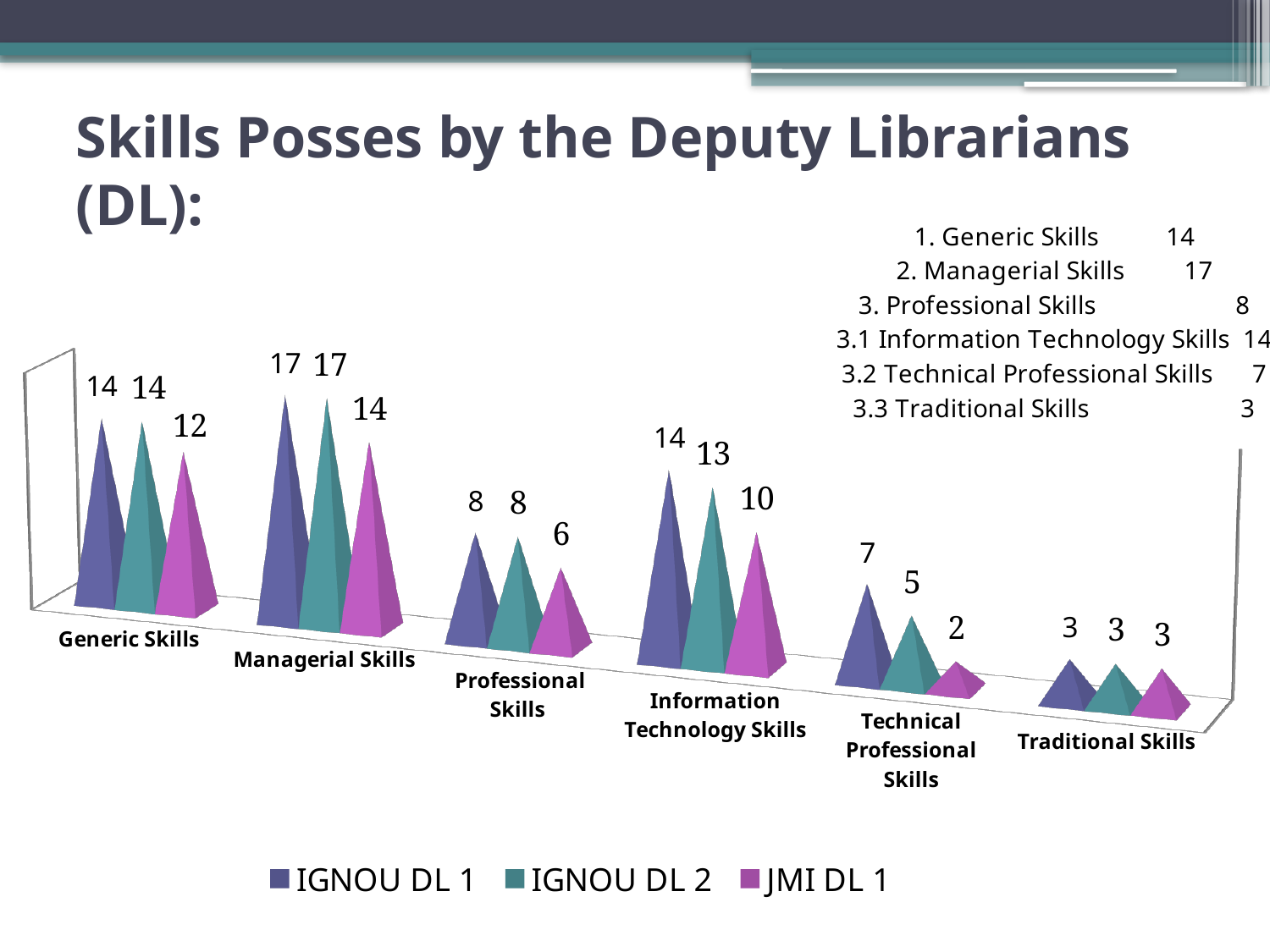
Which is larger: IGNOU DL 2 in Information Technology Skills or JMI DL 1 in Information Technology Skills? IGNOU DL 2 What is the value for JMI DL 1 in Generic Skills? 12 How many series does the legend list? 3 How many skill categories are shown on the x axis? 6 What is the value for IGNOU DL 1 in Managerial Skills? 17 What is the value for JMI DL 1 in Information Technology Skills? 10 What is the difference between IGNOU DL 1 and JMI DL 1 in Technical Professional Skills? 5 Which series is shown in purple/magenta in the legend? JMI DL 1 Which category has the highest value for JMI DL 1? Managerial Skills Which category has the lowest value for IGNOU DL 1? Traditional Skills What is the value for IGNOU DL 2 in Technical Professional Skills? 5 What kind of chart is shown on the slide? Bar chart